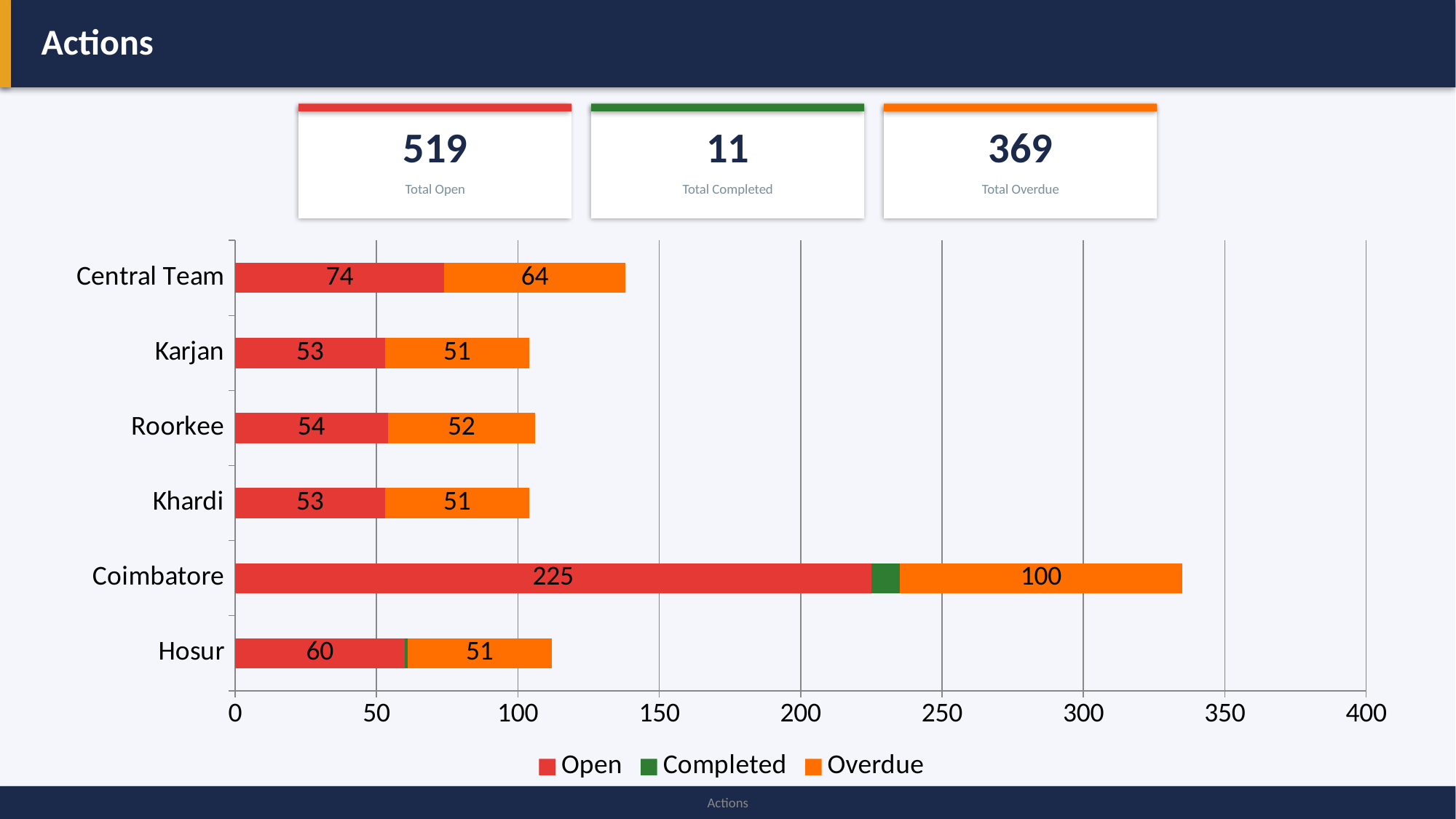
What is the Open value for Hosur? 60 How many series does the legend list? 3 Which category has the lowest Overdue value among those with a printed label other than 51? Roorkee What is the Open value for Coimbatore? 225 How many categories are plotted on the chart? 6 What is the total of the stacked bar for Central Team? 138 Which category has the highest Open value? Coimbatore What is the Overdue value for Central Team? 64 What is the difference between the Open values for Coimbatore and Central Team? 151 What kind of chart is shown on the slide? Stacked bar chart Is the Open value for Central Team larger than the Open value for Roorkee? Yes Is the total length of the Coimbatore bar greater or less than 300? greater